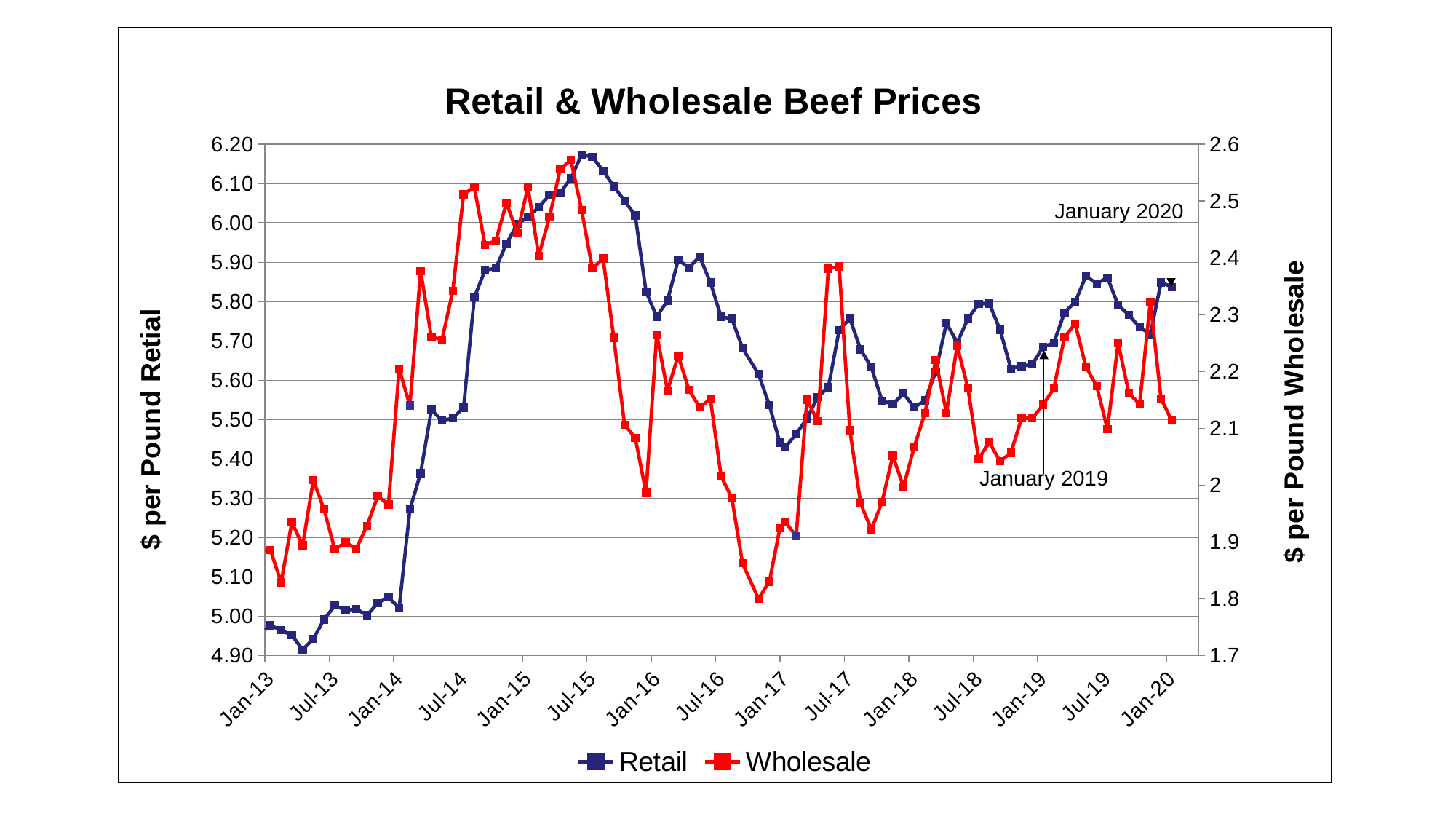
Is the Retail value at Jul-15 greater or less than 6.10? greater Around which x-axis label does the Retail series reach its highest value? Jul-15 Around which x-axis label does the Wholesale series reach its lowest value? Jan-17 Does the Retail series rise or fall between Jan-13 and Jul-15? rise Which is larger, the Retail value at Jul-15 or the Retail value at Jan-17? Jul-15 Is the Wholesale value at Jan-20 greater or less than 2.2? less How many series does the legend list? 2 Is the Retail value at Jan-13 greater or less than 5.10? less Which series is drawn in red? Wholesale What kind of chart is shown on the slide? line chart What is the title of the chart? Retail & Wholesale Beef Prices